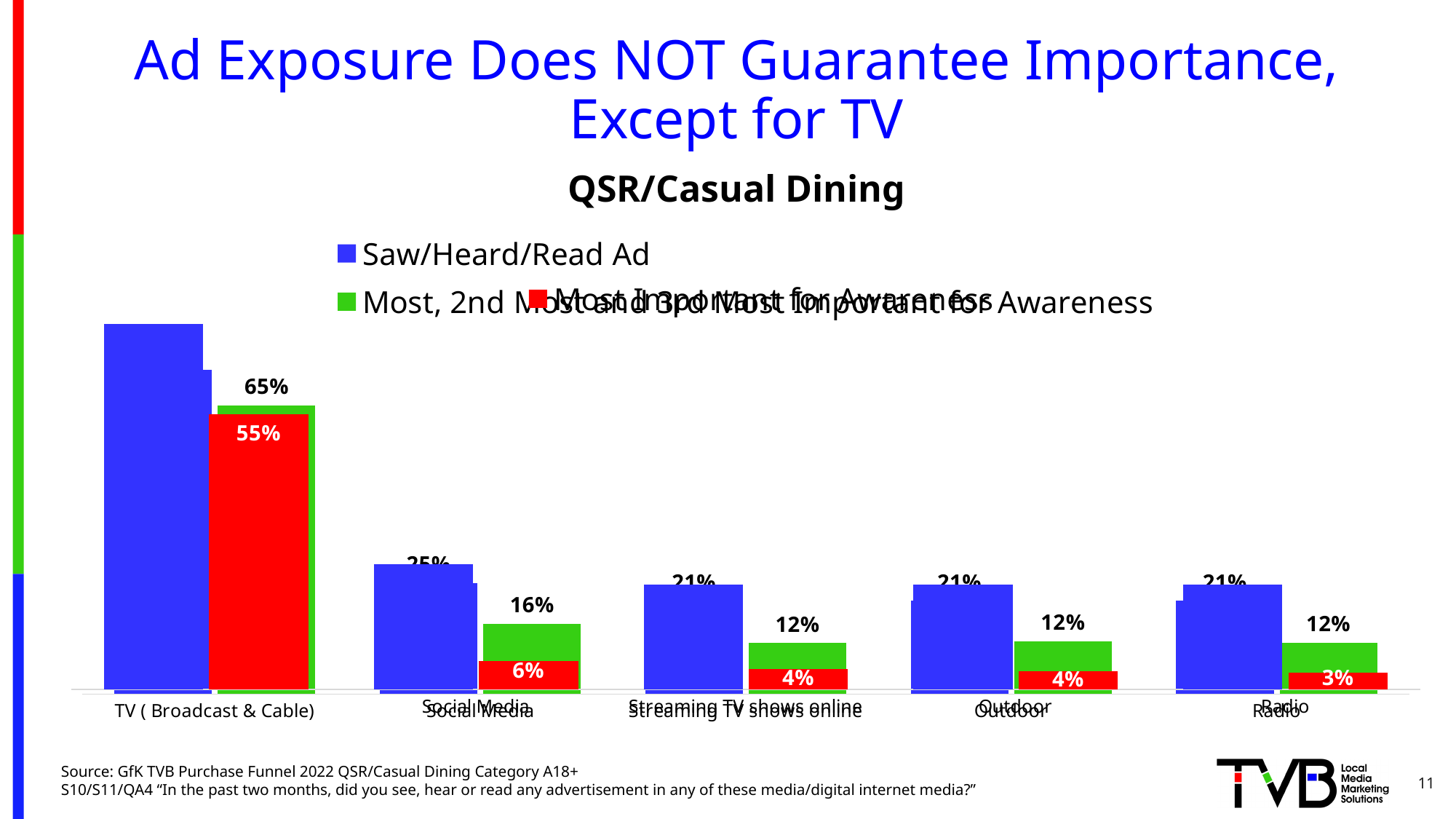
What is the 'Most Important for Awareness' value for Radio? 3% What is the 'Most, 2nd Most and 3rd Most Important for Awareness' value for Radio? 12% Which category has the lowest 'Most Important for Awareness' value? Radio Which category has the highest 'Most, 2nd Most and 3rd Most Important for Awareness' value? TV (Broadcast & Cable) What kind of chart is shown on the slide? bar chart Which has a larger 'Most, 2nd Most and 3rd Most Important for Awareness' value, Social Media or Outdoor? Social Media What is the difference between the 'Most, 2nd Most and 3rd Most Important for Awareness' value and the 'Most Important for Awareness' value for TV (Broadcast & Cable)? 10 percentage points What is the 'Most Important for Awareness' value for Social Media? 6% How many media categories are shown on the x axis of the chart? 5 What is the 'Most Important for Awareness' value for TV (Broadcast & Cable)? 55% What is the title of the chart? QSR/Casual Dining What is the 'Most, 2nd Most and 3rd Most Important for Awareness' value for TV (Broadcast & Cable)? 65%